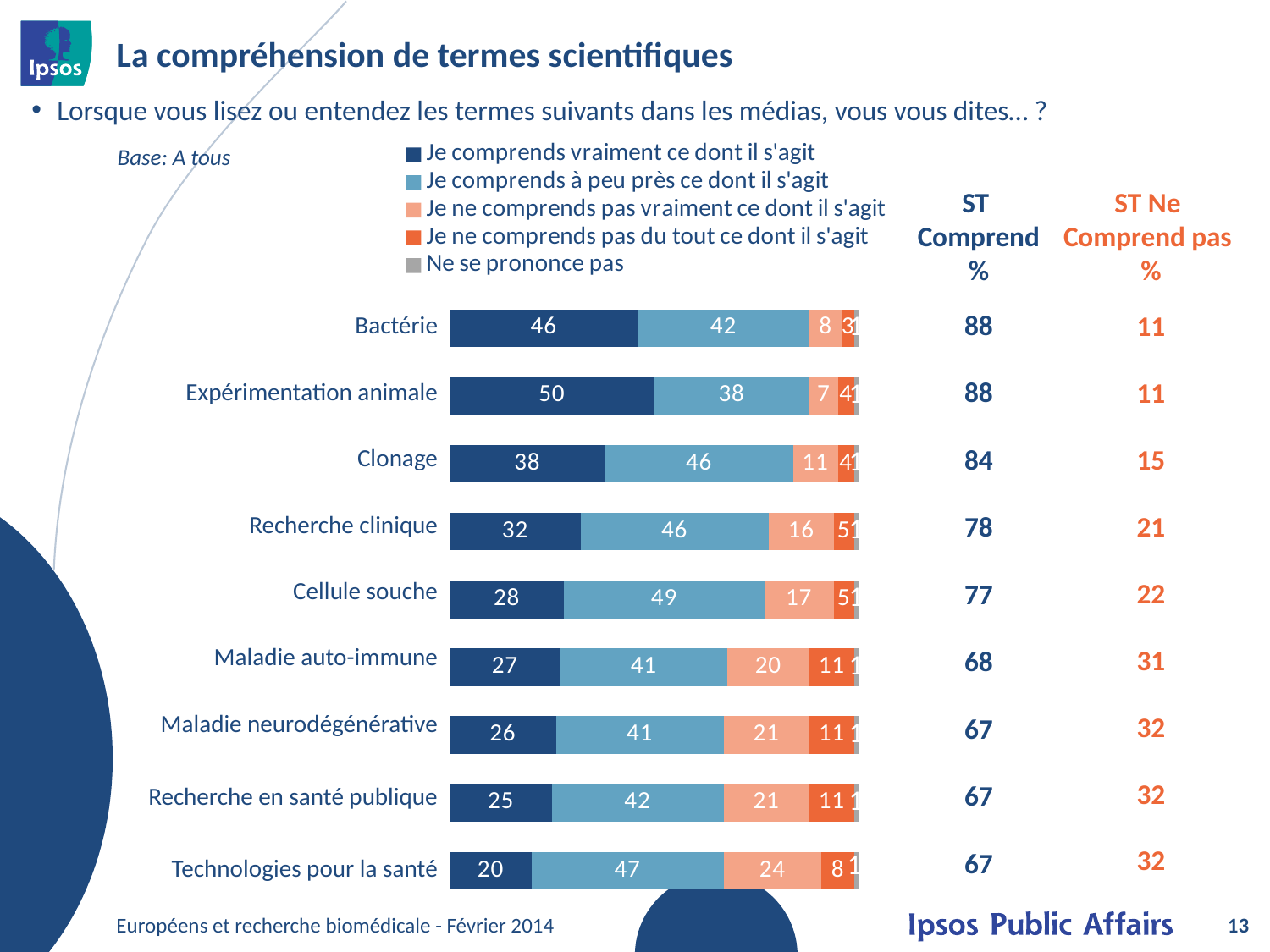
What is the value of "Je comprends à peu près ce dont il s'agit" for Technologies pour la santé? 47 Which term has the highest value for "Je comprends à peu près ce dont il s'agit"? Cellule souche How many series does the legend list? 5 What kind of chart is shown on the slide? Stacked bar chart Which term has the lowest value for "Je comprends vraiment ce dont il s'agit"? Technologies pour la santé Which term has the highest value for "Je comprends vraiment ce dont il s'agit"? Expérimentation animale How many scientific terms are shown in the chart? 9 What percentage of respondents say "Je comprends vraiment ce dont il s'agit" for Bactérie? 46 What is the value of "Je ne comprends pas du tout ce dont il s'agit" for Recherche en santé publique? 11 Which is larger: the "Je ne comprends pas vraiment ce dont il s'agit" value for Cellule souche or for Recherche clinique? Cellule souche What is the difference between the "Je comprends vraiment ce dont il s'agit" values for Expérimentation animale and Clonage? 12 What is the value of "Je ne comprends pas vraiment ce dont il s'agit" for Maladie auto-immune? 20